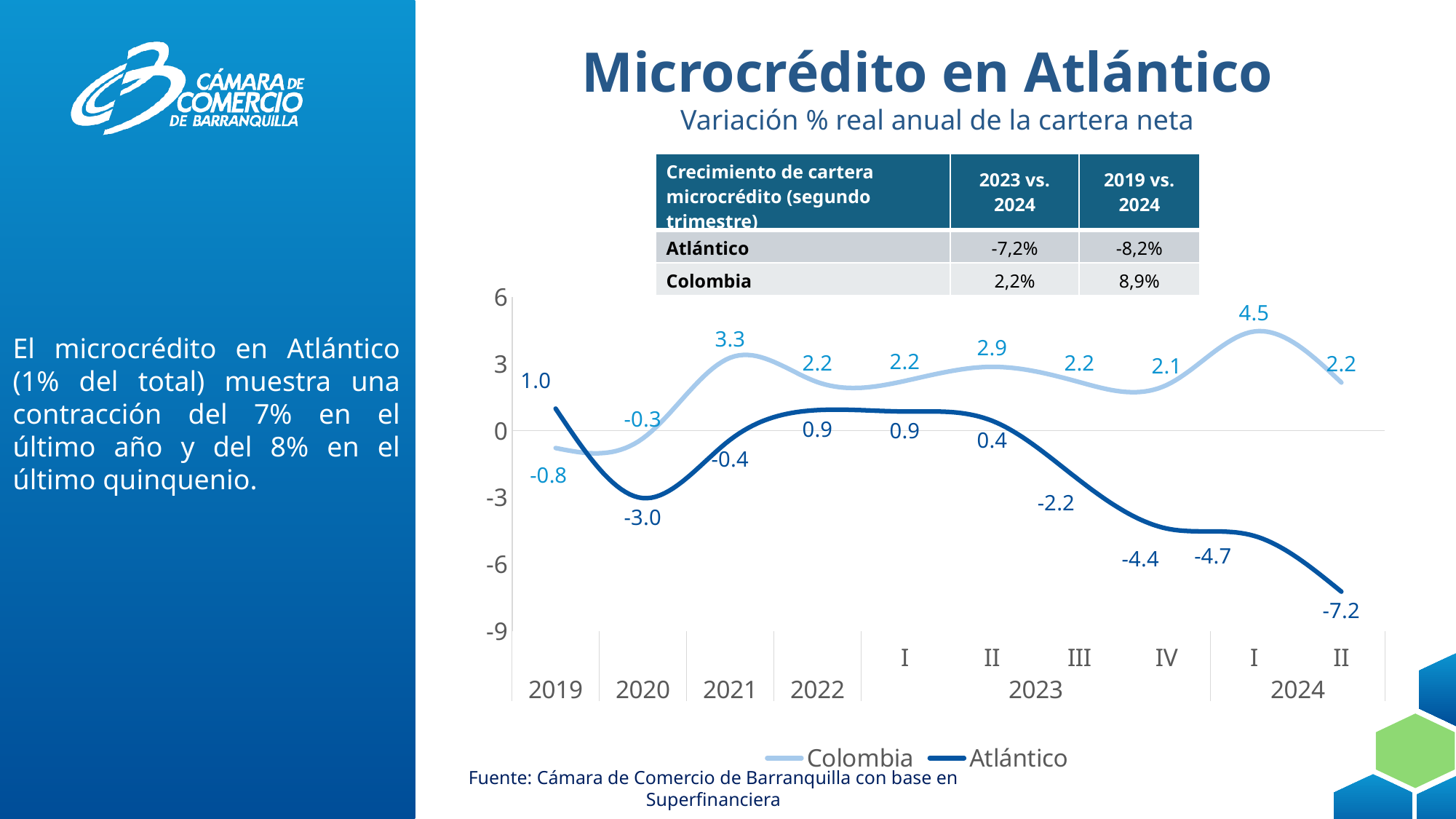
Does the Atlántico series rise or fall from the third quarter (III) of 2023 to the second quarter (II) of 2024? fall How many series does the chart legend list? 2 What is the value for Atlántico in 2020? -3.0 At which point on the x axis does the Colombia series reach its highest value? I 2024 Which series has the larger value in 2019, Colombia or Atlántico? Atlántico What is the difference between the Colombia and Atlántico values in the second quarter (II) of 2024? 9.4 What is the value for Colombia in the first quarter (I) of 2024? 4.5 What kind of chart is shown on the slide? line chart What is the value for Atlántico in the second quarter (II) of 2024? -7.2 What is the value for Colombia in 2021? 3.3 How many data points are plotted for each series in the chart? 10 At which point on the x axis does the Atlántico series reach its lowest value? II 2024